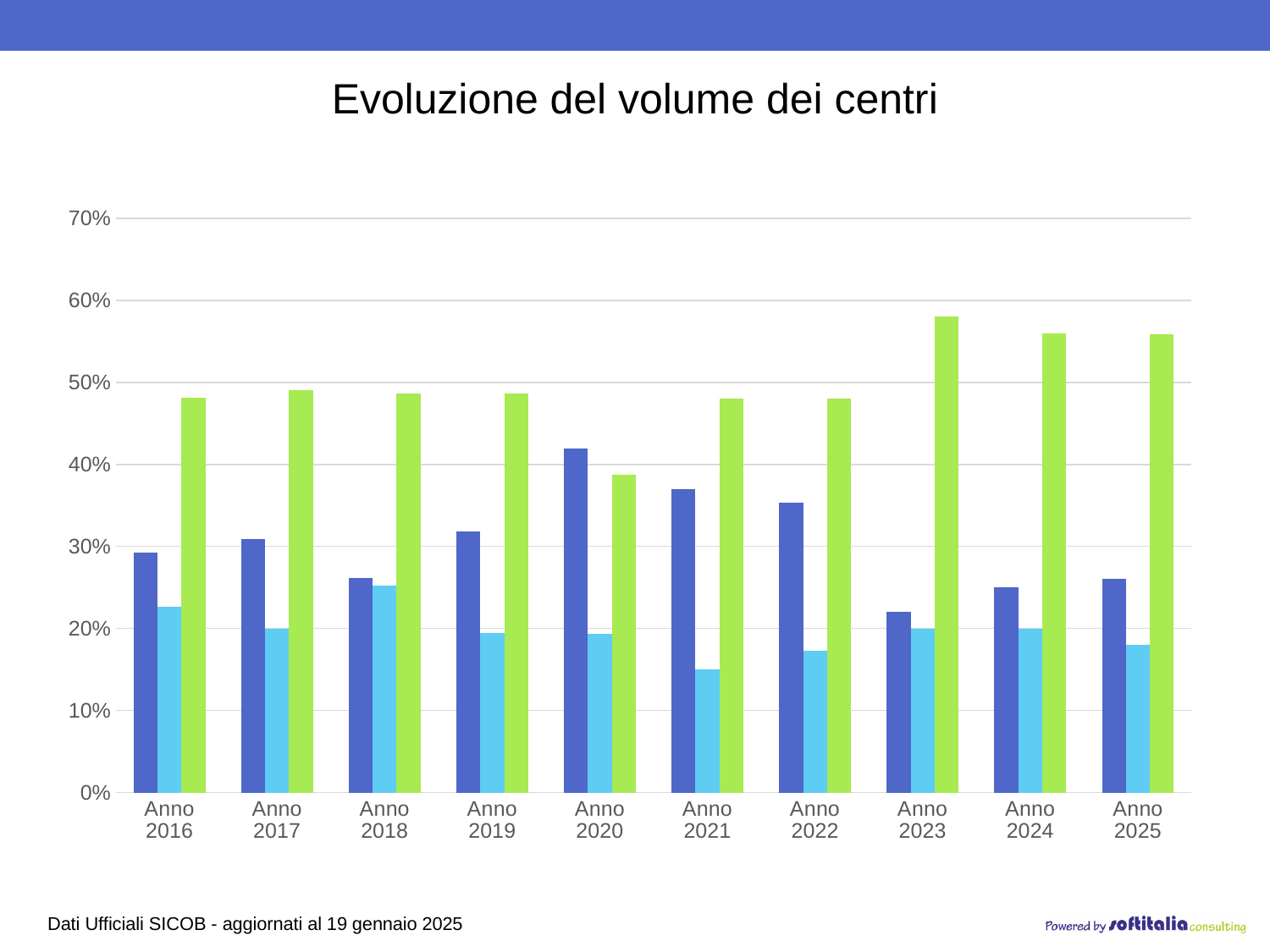
How many bars are plotted for each year? 3 What is the title of the chart? Evoluzione del volume dei centri In which year is the dark blue bar the highest? Anno 2020 For Anno 2020, which bar is taller: the dark blue bar or the green bar? the dark blue bar Is the value of the green bar for Anno 2023 greater or less than 50%? greater What kind of chart is shown on the slide? bar chart In which year is the green bar the highest? Anno 2023 In which year is the light blue bar the lowest? Anno 2021 Which is larger: the green bar for Anno 2016 or the green bar for Anno 2023? Anno 2023 Is the value of the dark blue bar for Anno 2020 greater or less than 40%? greater Is the value of the light blue bar for Anno 2021 greater or less than 20%? less How many years (categories) are shown on the x axis? 10